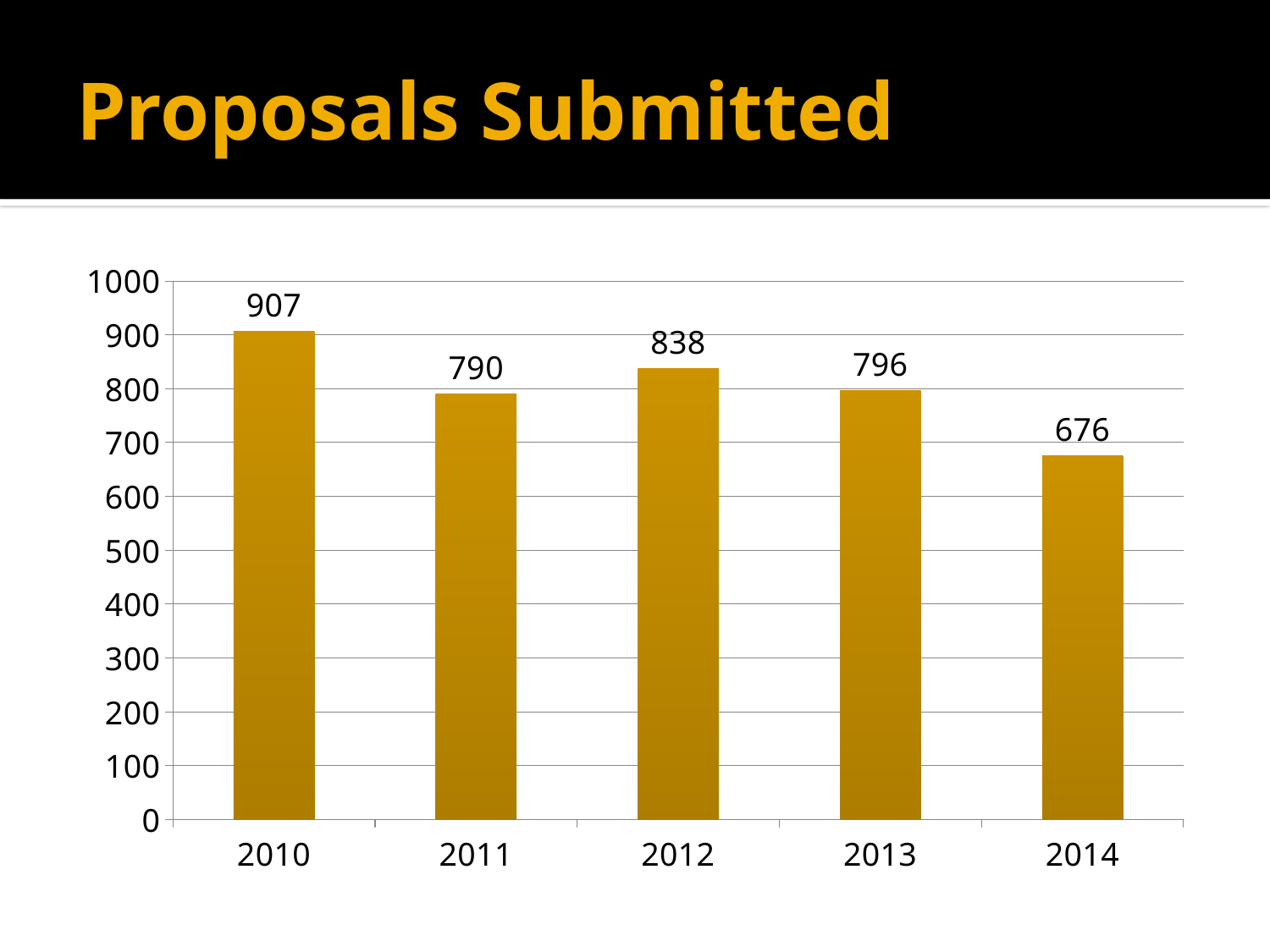
How many proposals were submitted in 2010? 907 Which year has the highest number of proposals submitted? 2010 What is the value shown for 2014? 676 How many years are shown on the x axis? 5 What kind of chart is shown on the slide? Bar chart What is the difference between the values for 2012 and 2011? 48 Which year has a larger value, 2012 or 2013? 2012 Is the value for 2013 greater or less than 700? greater Which year has the lowest number of proposals submitted? 2014 What is the difference between the values for 2010 and 2014? 231 What is the title of the slide? Proposals Submitted What is the value shown for 2012? 838